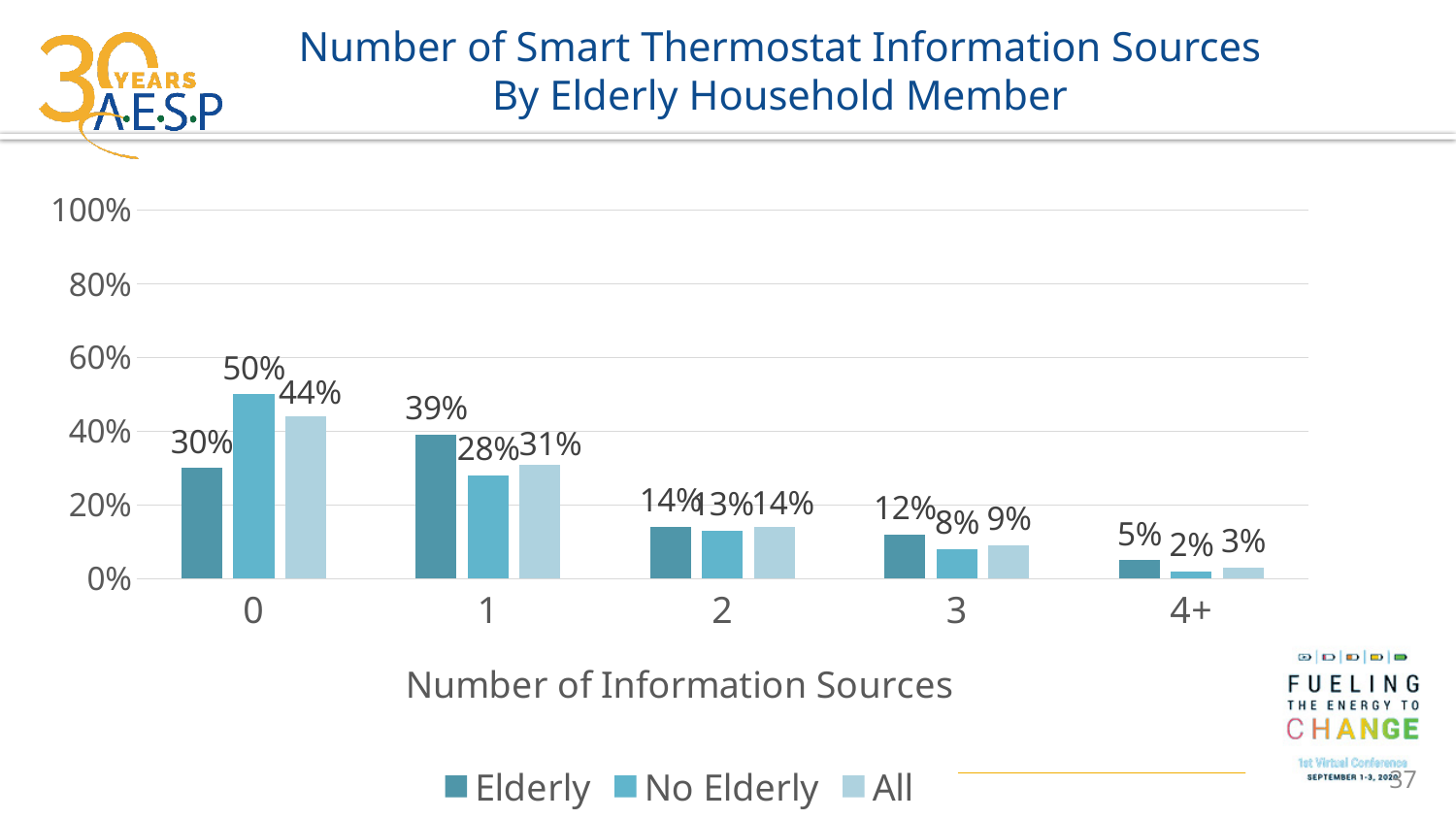
What kind of chart is shown on the slide? bar chart Which category has the highest value for the No Elderly series? 0 What is the difference between the No Elderly and Elderly values at 0 information sources? 20% Is the value for No Elderly at 0 information sources greater or less than 40%? greater What is the value for All at 4+ information sources? 3% Which category has the lowest value for the Elderly series? 4+ What is the value for No Elderly at 1 information source? 28% Do the values for the All series rise or fall from 1 to 4+ information sources? fall At 1 information source, which is larger: Elderly or All? Elderly How many series does the legend list? 3 How many categories are shown on the x axis? 5 What is the value for Elderly at 0 information sources? 30%